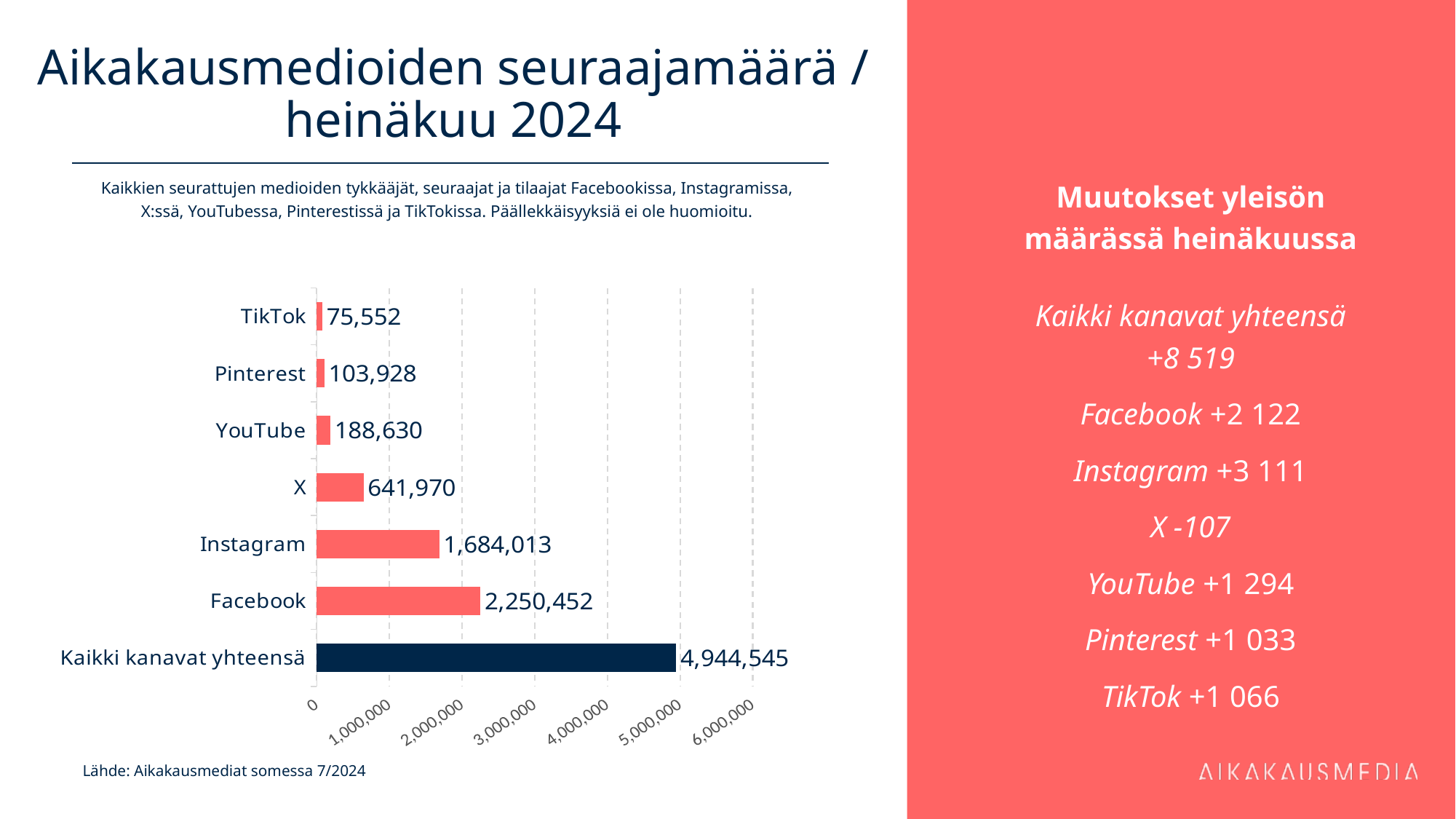
What is the difference between the Pinterest and TikTok values in the chart? 28,376 What is the value shown for TikTok in the bar chart? 75,552 Which is larger in the chart, the value for X or the value for YouTube? X Which category has the lowest value in the chart? TikTok Is the value for Instagram greater or less than 2,000,000? less How many categories are shown in the bar chart? 7 What is the value shown for Instagram in the bar chart? 1,684,013 What is the value shown for Kaikki kanavat yhteensä in the bar chart? 4,944,545 Which individual channel (excluding the total bar) has the highest value in the chart? Facebook What is the difference between the Facebook and Instagram values in the chart? 566,439 What is the value shown for Facebook in the bar chart? 2,250,452 What kind of chart is shown on the slide? bar chart